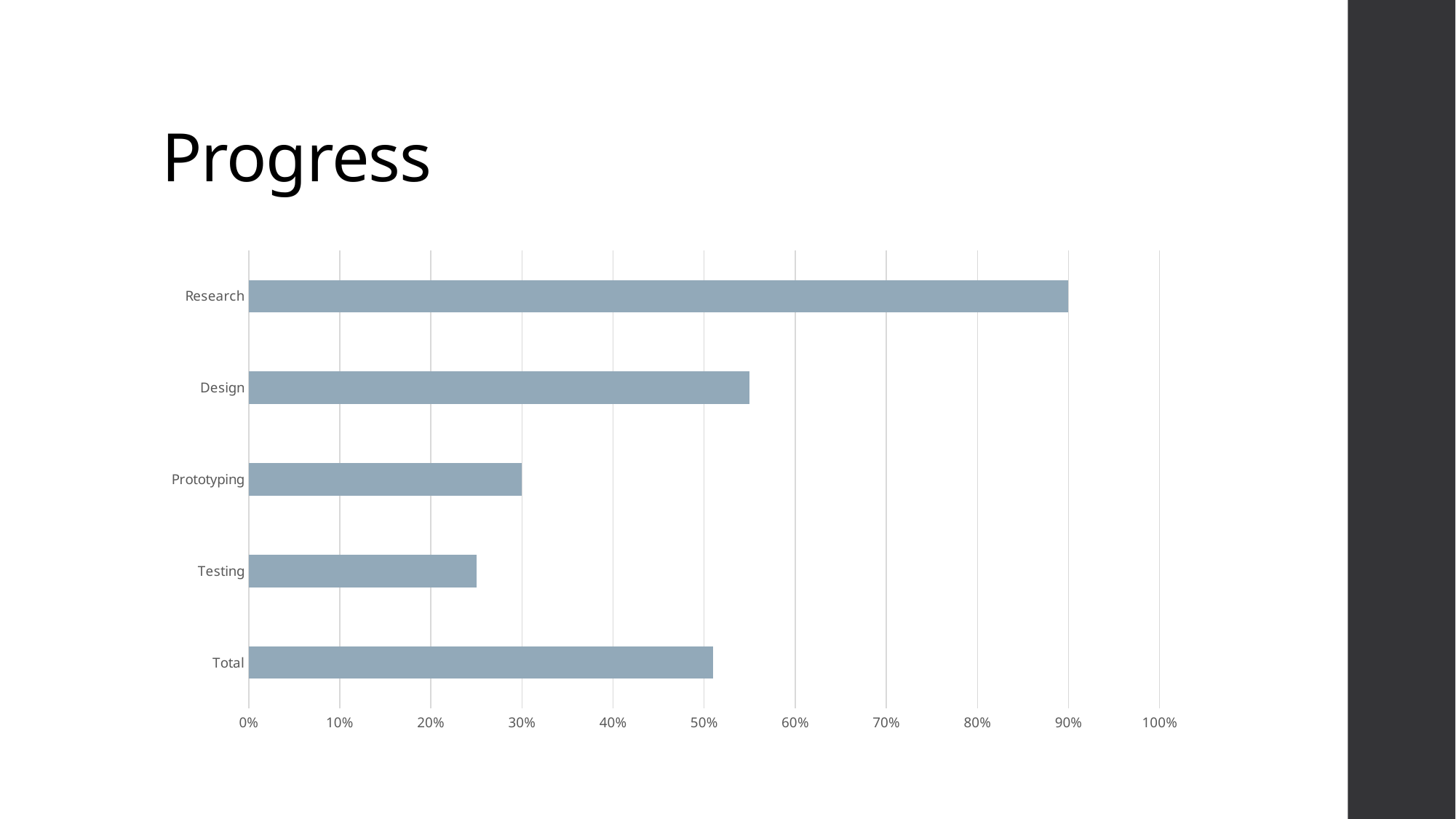
What is the title of the slide containing the chart? Progress What is the value for Research? 90% Which category has the lowest value? Testing Which is larger, the value for Design or the value for Prototyping? Design Is the value for Total greater or less than 60%? less What is the value for Prototyping? 30% Is the value for Design greater or less than 50%? greater How many categories are plotted in the chart? 5 Is the value for Testing greater or less than 30%? less What is the difference between the values for Research and Prototyping? 60% Which category has the highest value? Research What kind of chart is shown on the slide? Bar chart